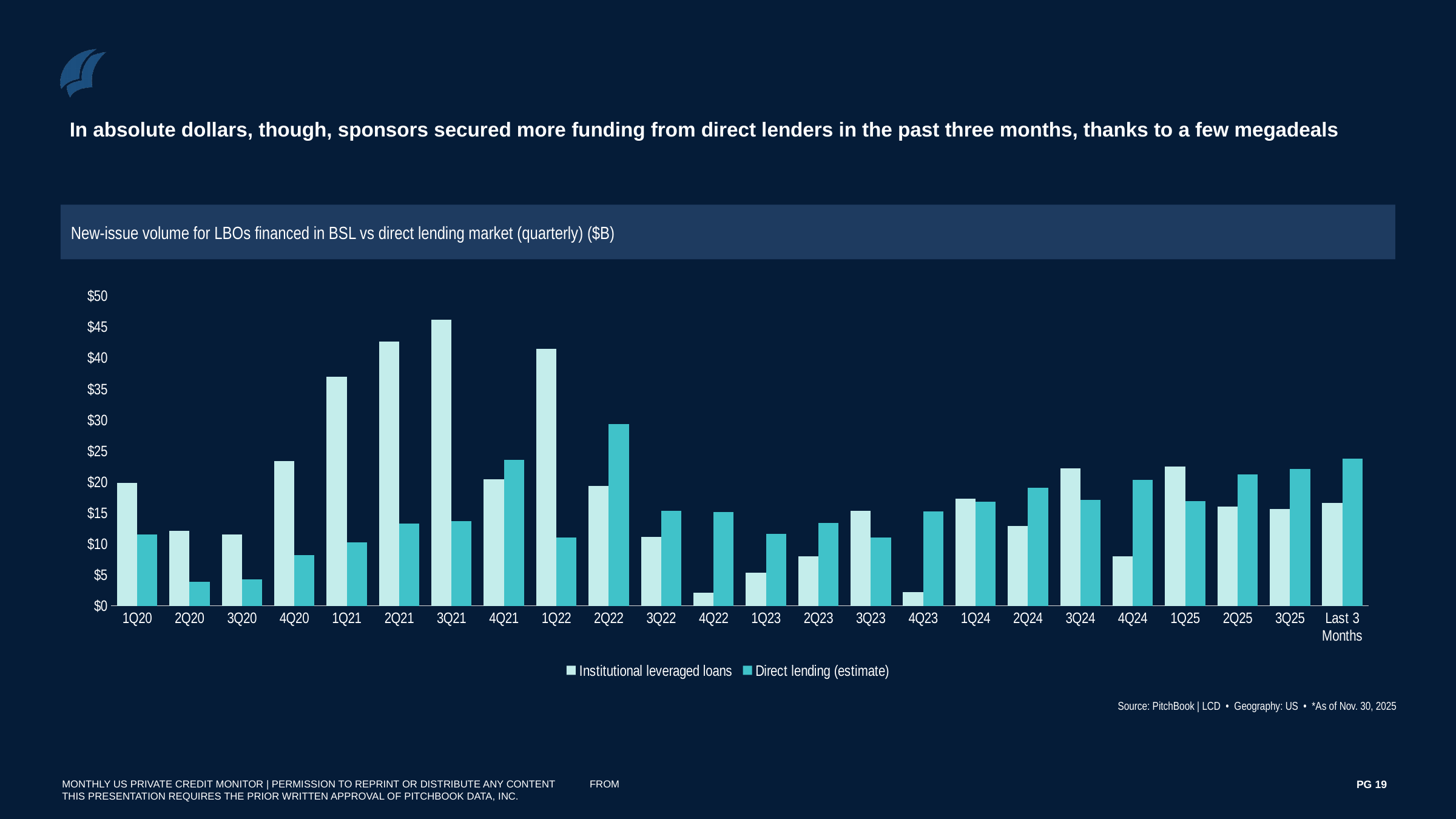
For 3Q21, which is larger: Institutional leveraged loans or Direct lending (estimate)? Institutional leveraged loans In which quarter is the Institutional leveraged loans value highest? 3Q21 Is the Direct lending (estimate) value for Last 3 Months greater or less than $20? greater Is the Institutional leveraged loans value for 4Q22 greater or less than $5? less Is the Institutional leveraged loans value for 3Q21 greater or less than $40? greater In which quarter is the Direct lending (estimate) value highest? 2Q22 What is the title of the chart? New-issue volume for LBOs financed in BSL vs direct lending market (quarterly) ($B) What kind of chart is shown on the slide? Bar chart For Last 3 Months, which is larger: Institutional leveraged loans or Direct lending (estimate)? Direct lending (estimate) How many series does the legend list? 2 How many categories are shown on the x axis? 24